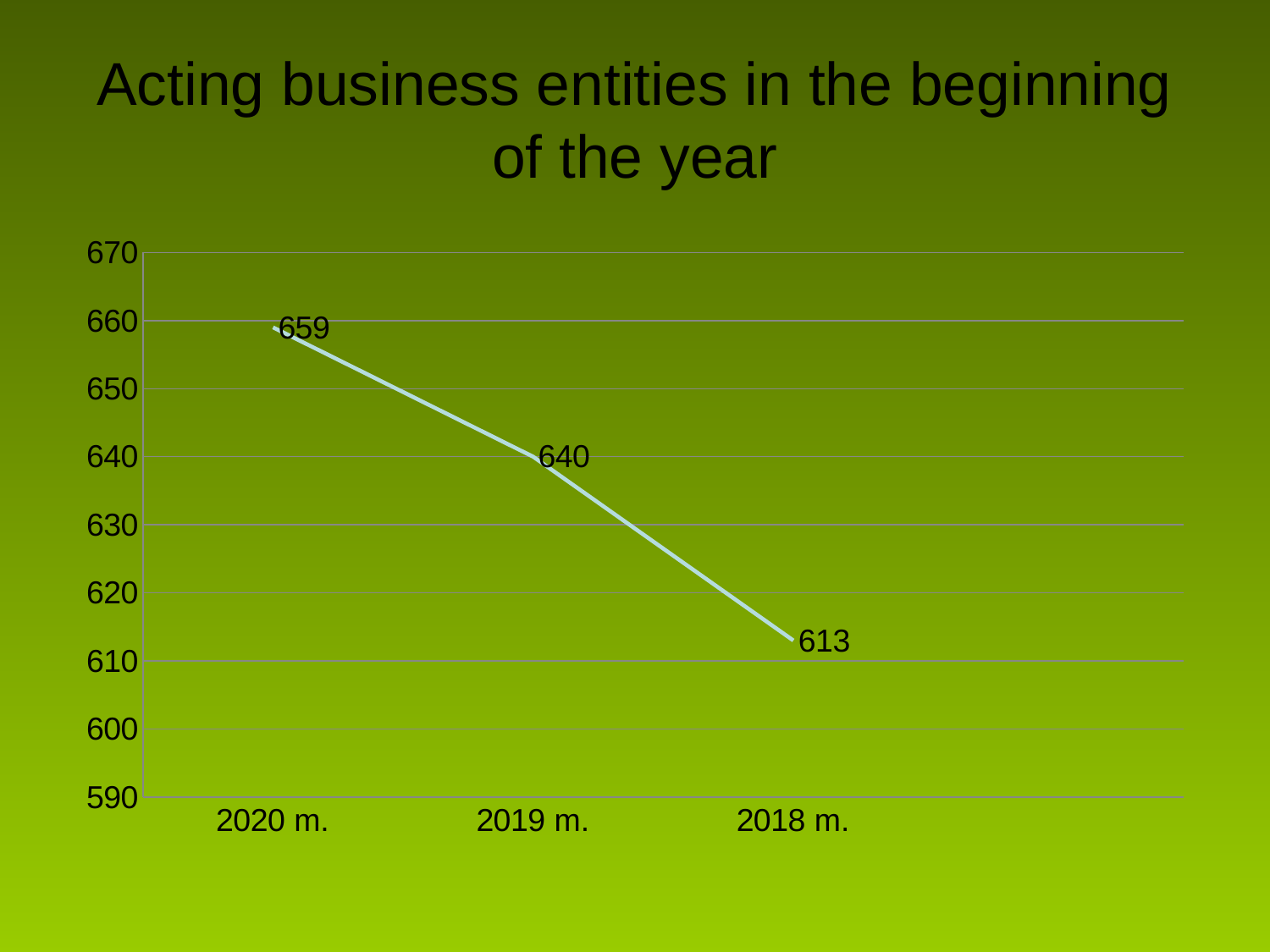
What is the difference between the values for 2019 m. and 2018 m.? 27 Which year has the highest value? 2020 m. What is the value for 2019 m.? 640 Which year has the lowest value? 2018 m. How many data points are plotted on the chart? 3 What is the value for 2020 m.? 659 What is the value for 2018 m.? 613 What kind of chart is shown on the slide? line chart What is the difference between the values for 2020 m. and 2018 m.? 46 Which is larger, the value for 2020 m. or the value for 2019 m.? 2020 m. Is the value for 2018 m. greater or less than 620? less Do the values rise or fall from left to right along the x axis? fall